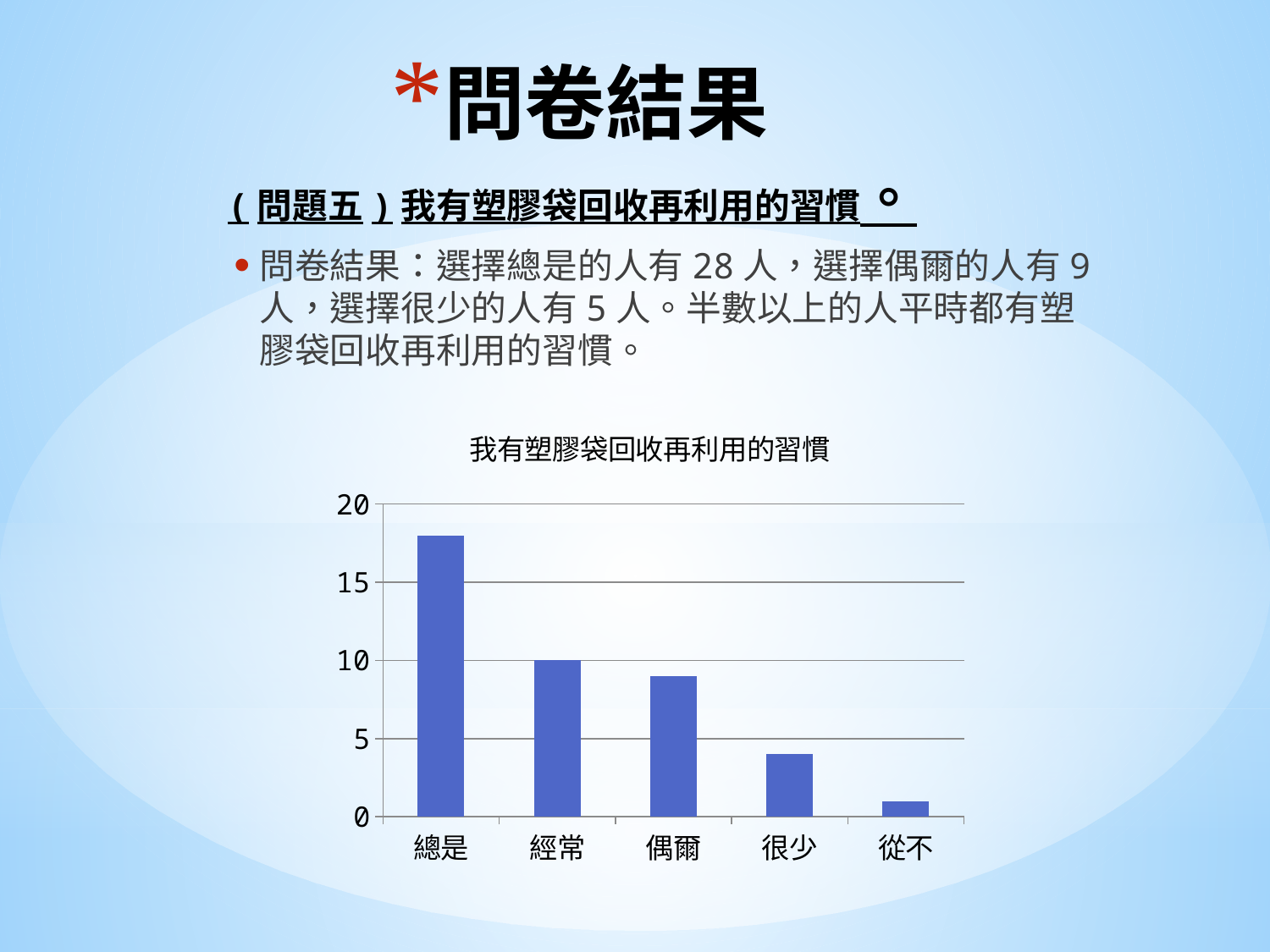
What is the title of the chart? 我有塑膠袋回收再利用的習慣 What is the value for 經常 in the chart? 10 Is the value for 很少 greater or less than 5? less What kind of chart is shown on the slide? bar chart How many categories are shown on the x axis of the chart? 5 Is the value for 從不 greater or less than 5? less Which is larger, the value for 總是 or the value for 經常? 總是 Do the bar values rise or fall from left to right along the x axis? fall Which category has the highest bar in the chart? 總是 Is the value for 偶爾 greater or less than 10? less Which category has the lowest bar in the chart? 從不